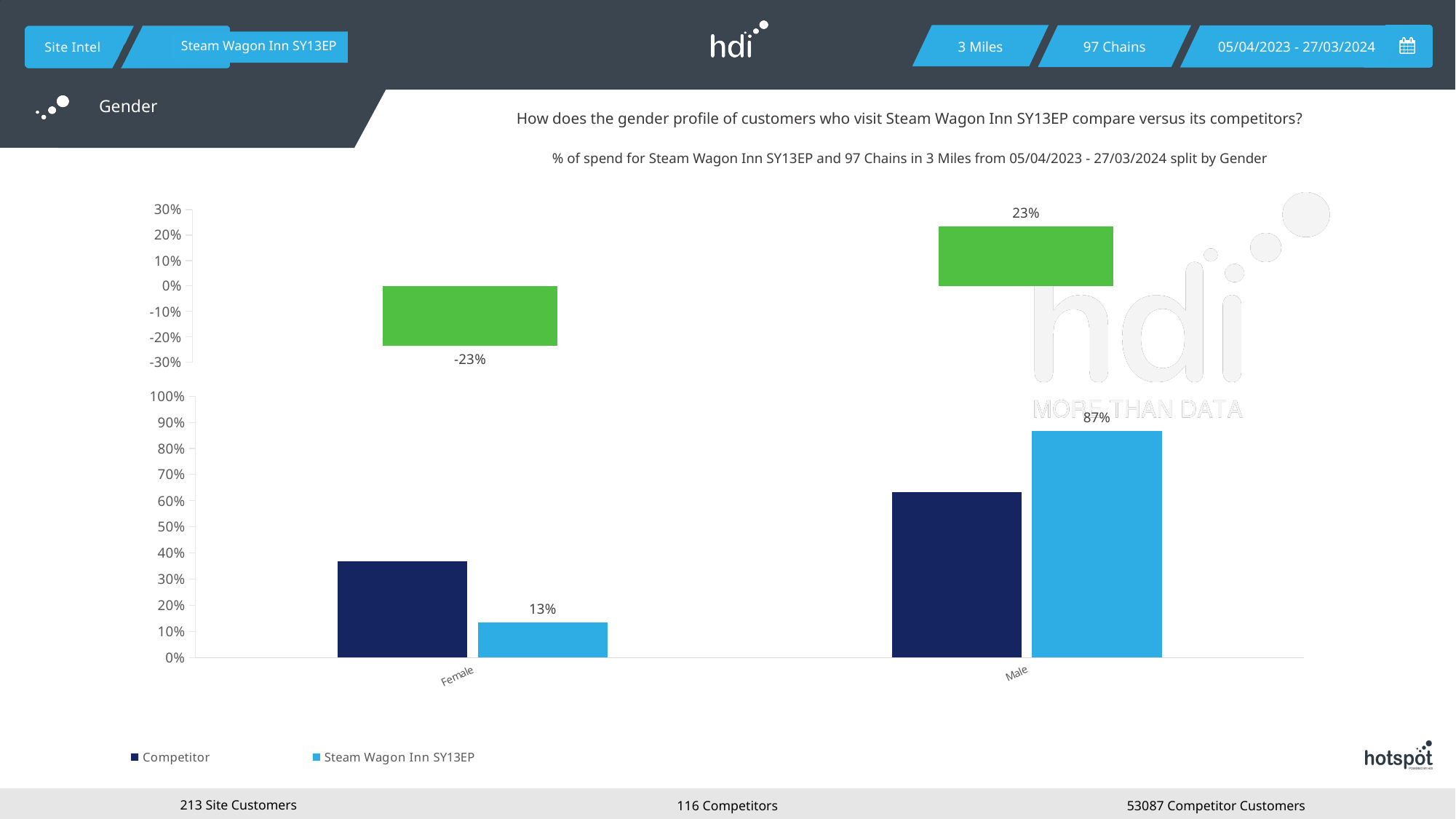
How many series does the legend of the bottom chart list? 2 What kind of chart is the bottom chart? Bar chart In the bottom chart, what is the value for Steam Wagon Inn SY13EP for Male? 87% In the bottom chart, for Male, which is larger: the Competitor value or the Steam Wagon Inn SY13EP value? Steam Wagon Inn SY13EP In the bottom chart, what is the value for Steam Wagon Inn SY13EP for Female? 13% In the bottom chart, is the Competitor value for Female greater or less than 30%? greater In the bottom chart, for Female, which is larger: the Competitor value or the Steam Wagon Inn SY13EP value? Competitor In the bottom chart, what is the difference between the Steam Wagon Inn SY13EP values for Male and Female? 74% In the top chart, what is the value shown for Male? 23% In the bottom chart, which gender has the higher value for Steam Wagon Inn SY13EP? Male In the bottom chart, is the Competitor value for Male greater or less than 70%? less In the top chart, what is the value shown for Female? -23%